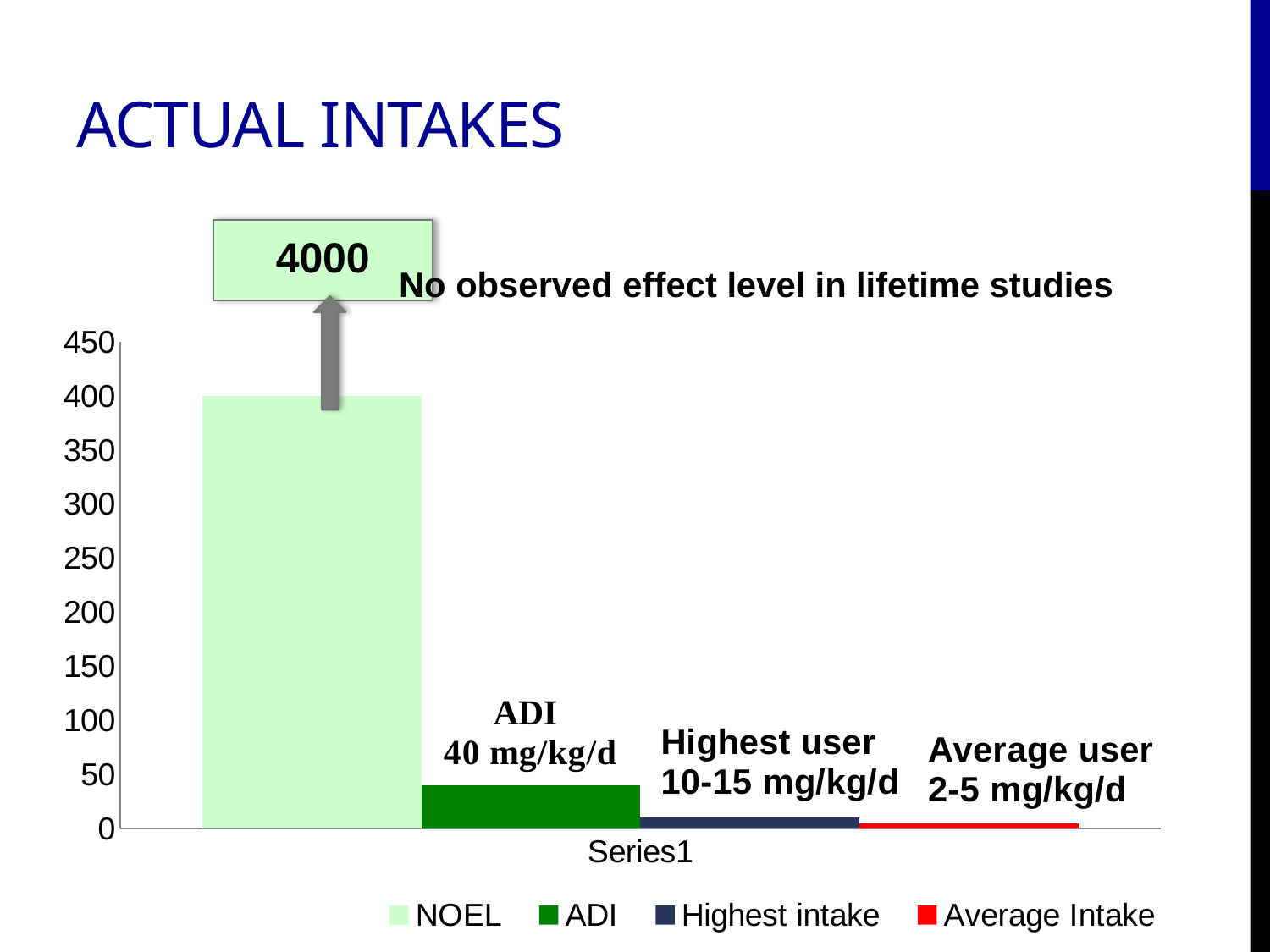
What intake range is labelled for the average user? 2-5 mg/kg/d How many series does the legend list? 4 What kind of chart is shown on the slide? bar chart What value is labelled for ADI on the chart? 40 mg/kg/d What intake range is labelled for the highest user? 10-15 mg/kg/d Which series has the shortest bar? Average Intake Which series has the tallest bar? NOEL What is the title of the slide containing the chart? ACTUAL INTAKES Is the NOEL bar greater or less than 350 on the axis? greater Is the value for Highest intake greater or less than 50? less Which is larger, the ADI bar or the Highest intake bar? ADI What colour is the Average Intake series in the legend? red